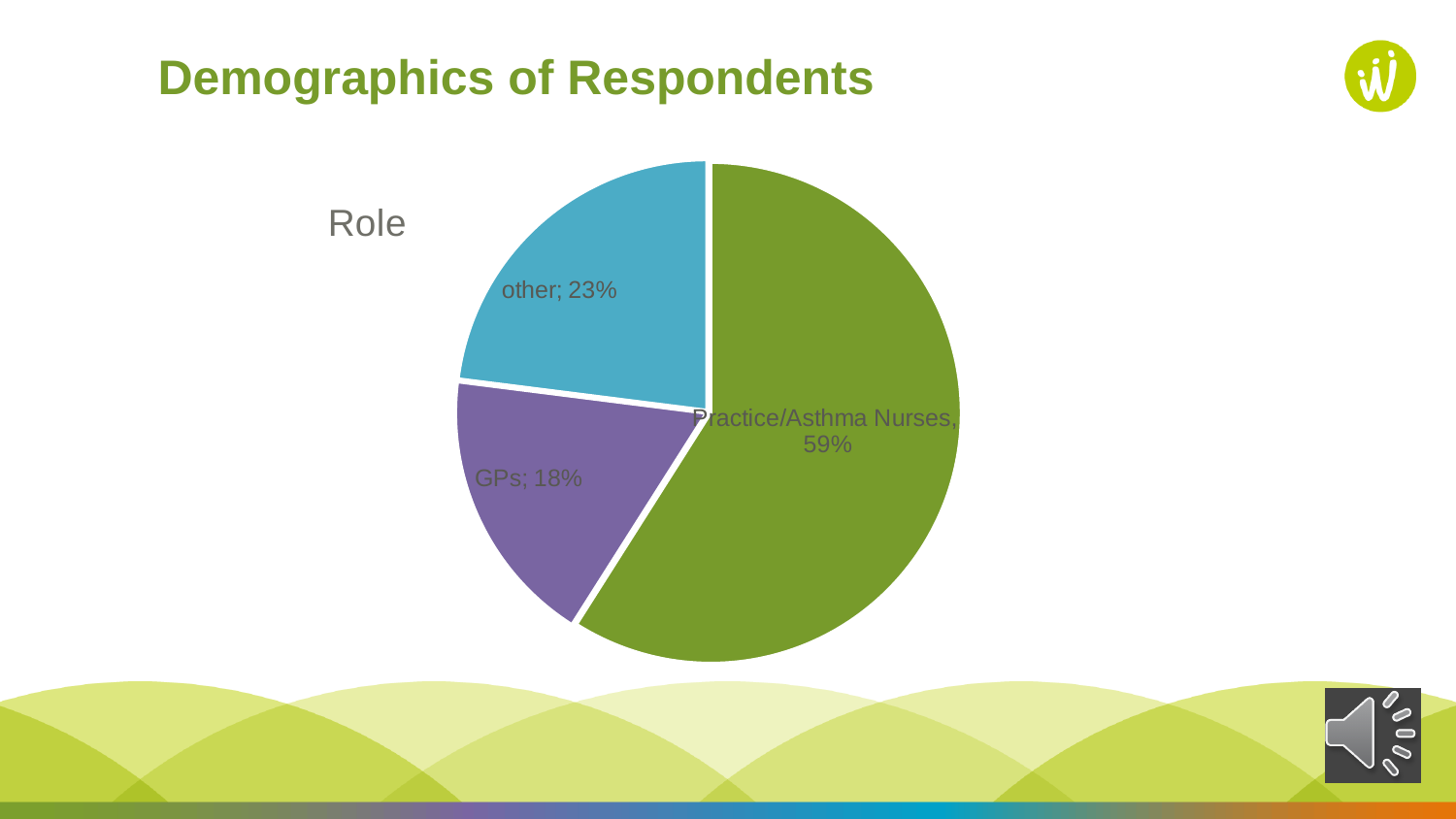
What colour is the Practice/Asthma Nurses slice? green What is the difference in percentage points between Practice/Asthma Nurses and GPs? 41 What kind of chart is shown on the slide? pie chart What share of respondents fall into the 'other' category? 23% What share of respondents are GPs? 18% What share of respondents are Practice/Asthma Nurses? 59% Which is larger, the share for 'other' or the share for GPs? other Which role has the smallest share of respondents? GPs What is the difference in percentage points between 'other' and GPs? 5 What is the title of the pie chart? Role Which role has the largest share of respondents? Practice/Asthma Nurses How many slices does the pie chart have? 3